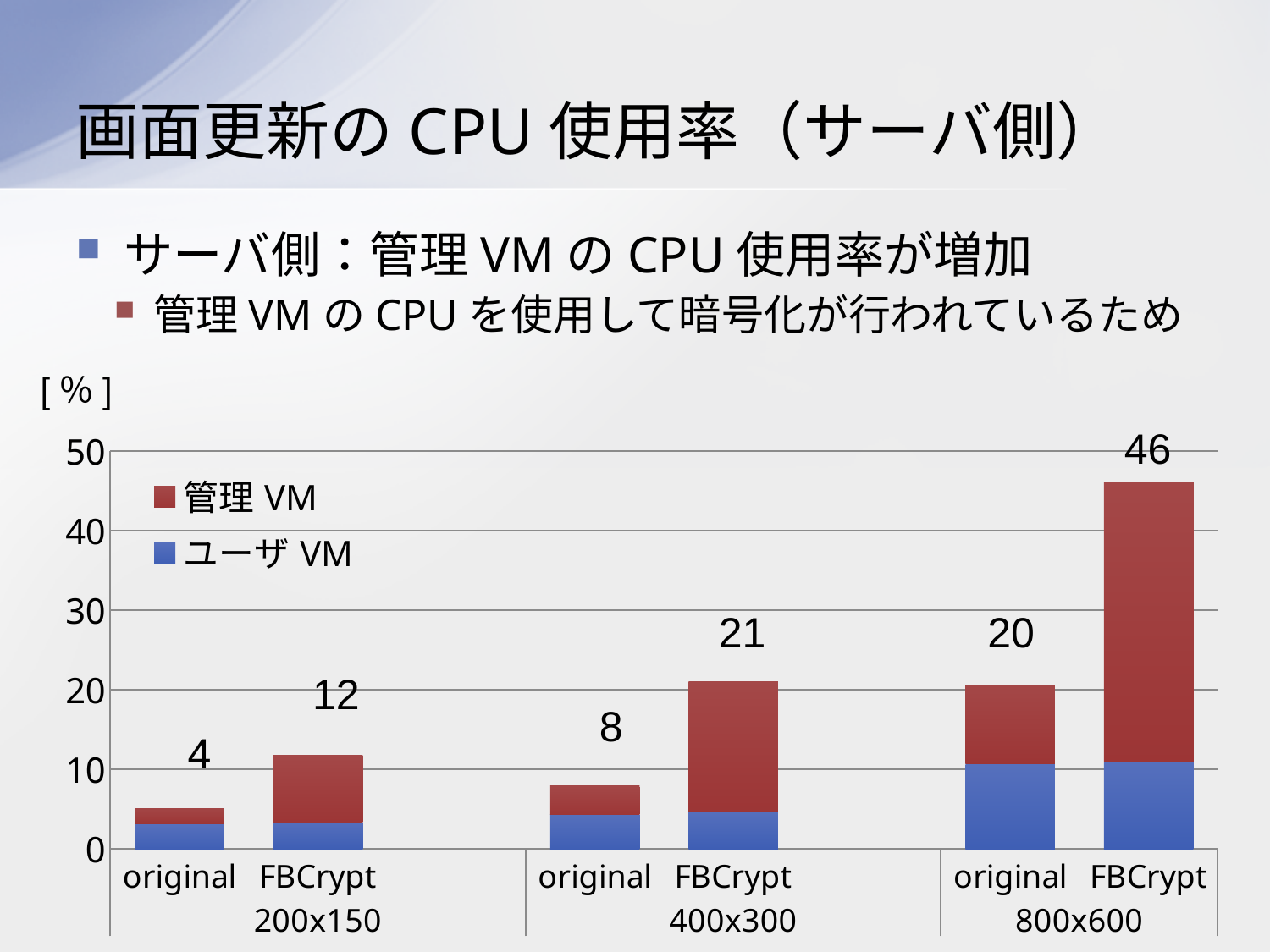
Which bar has the highest labelled total CPU usage? FBCrypt at 800x600 How many bars are plotted in the chart? 6 Which series is shown in red in the legend? 管理 VM How many series does the legend list? 2 What is the difference between the labelled totals for FBCrypt and original at 800x600? 26 Which bar has the lowest labelled total CPU usage? original at 200x150 Is the ユーザ VM portion of the FBCrypt bar at 800x600 greater or less than 20? less What is the total CPU usage labelled for the FBCrypt bar at 800x600? 46 What kind of chart is shown on the slide? stacked bar chart What is the total CPU usage labelled for the original bar at 400x300? 8 Which has the larger labelled total at 400x300, original or FBCrypt? FBCrypt What is the total CPU usage labelled for the FBCrypt bar at 200x150? 12